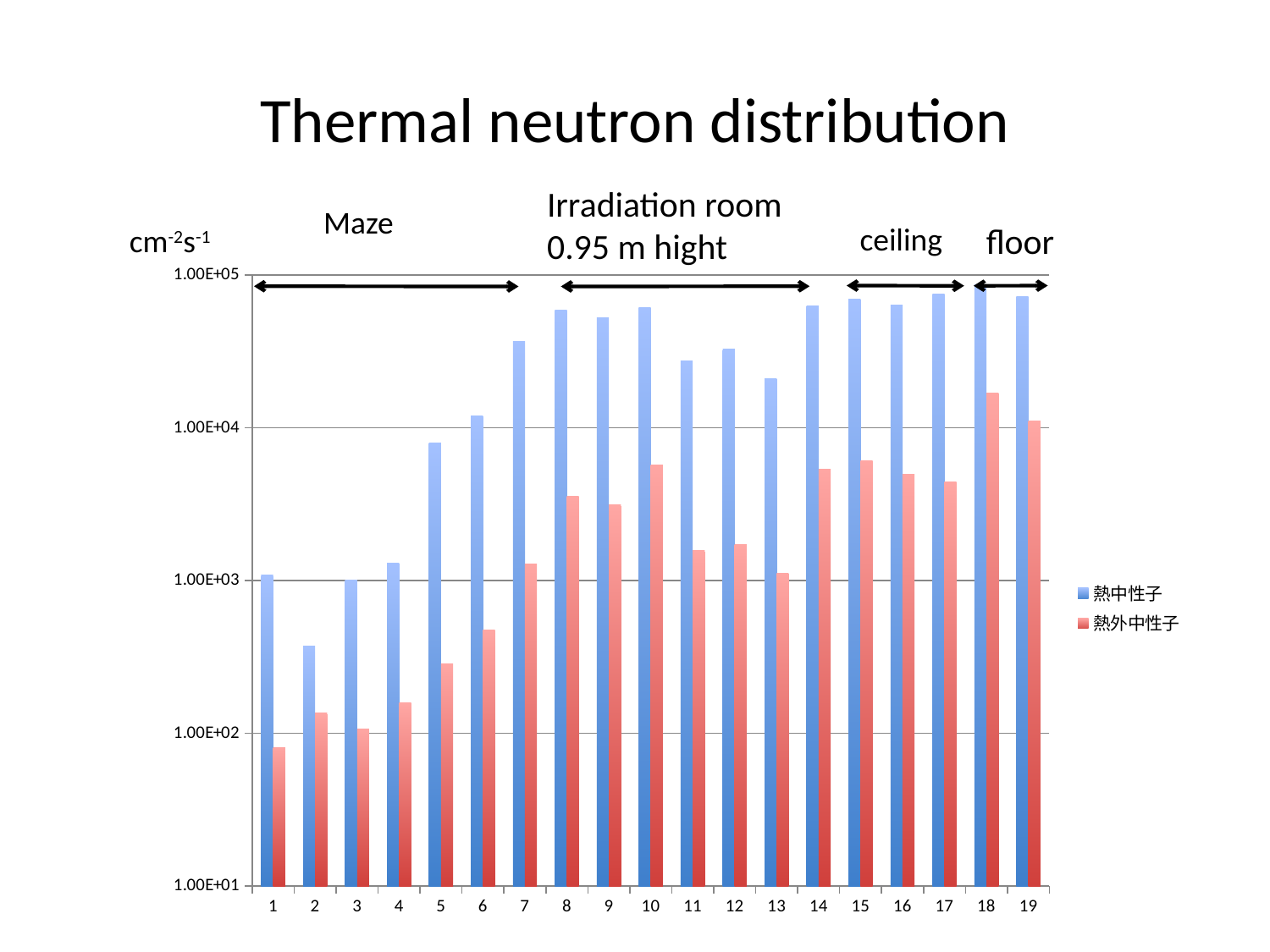
Is the value for 熱中性子 at category 2 greater or less than 1.00E+03? less Do the values for 熱中性子 rise or fall from category 1 to category 7? rise Is the value for 熱外中性子 at category 18 greater or less than 1.00E+04? greater How many series does the legend list? 2 What unit is written above the vertical axis? cm⁻²s⁻¹ What kind of chart is shown on the slide? bar chart Which category has the lowest value for 熱外中性子? 1 Which is larger, the value for 熱中性子 at category 7 or at category 8? category 8 Which category has the lowest value for 熱中性子? 2 Is the value for 熱外中性子 at category 1 greater or less than 1.00E+02? less Which category has the highest value for 熱外中性子? 18 How many categories are shown along the x axis? 19